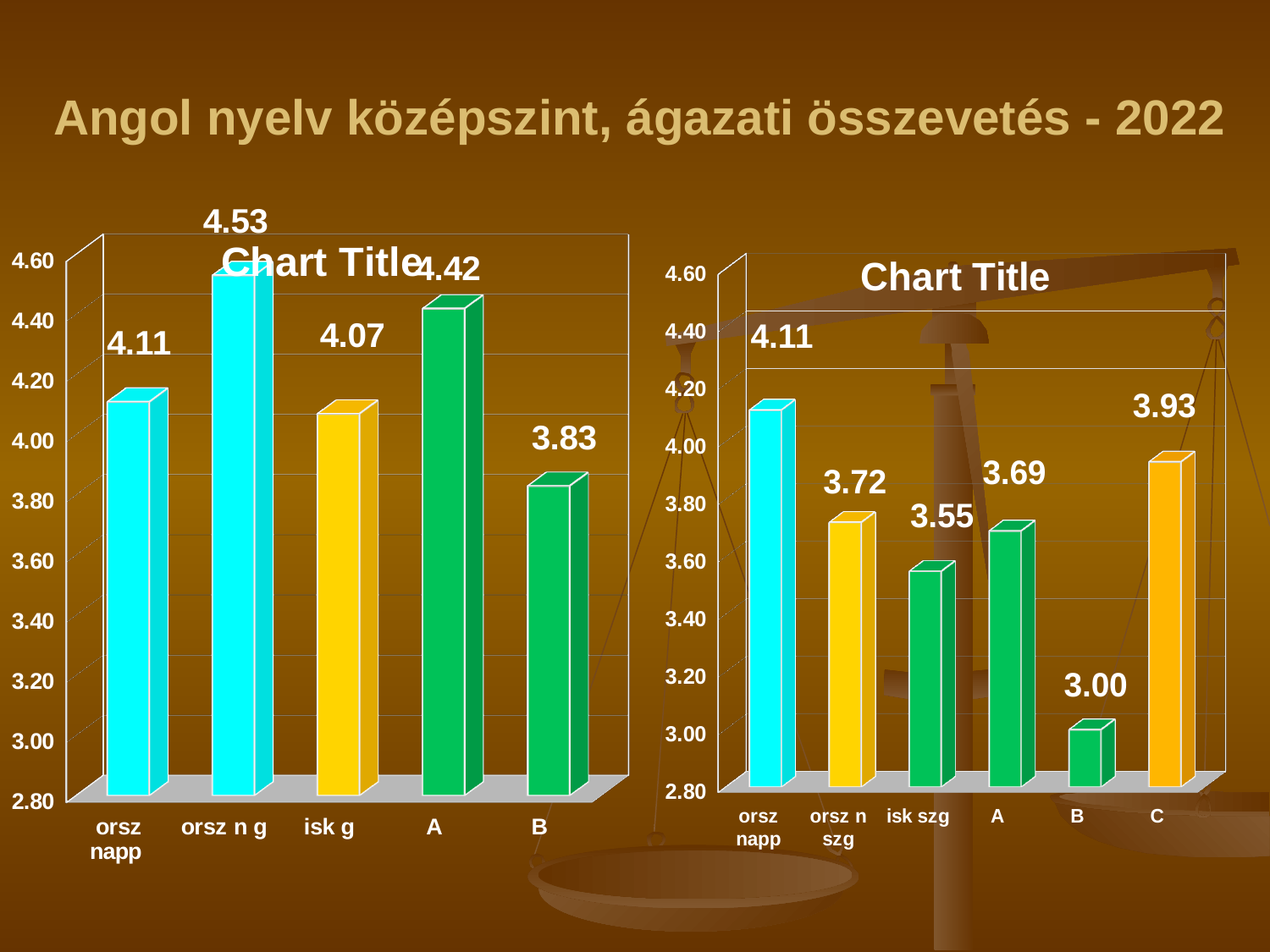
In the right chart, which category has the lowest value? B In the right chart, what is the value for isk szg? 3.55 In the right chart, which is larger, the value for orsz n szg or the value for A? orsz n szg In the left chart, what is the value for orsz n g? 4.53 In the left chart, which category has the lowest value? B What kind of chart is the right chart? bar chart In the left chart, how many categories are shown? 5 In the right chart, how many categories are shown? 6 In the right chart, what is the value for C? 3.93 In the left chart, what is the difference between the values for A and isk g? 0.35 In the left chart, which category has the highest value? orsz n g In the left chart, what is the value for B? 3.83